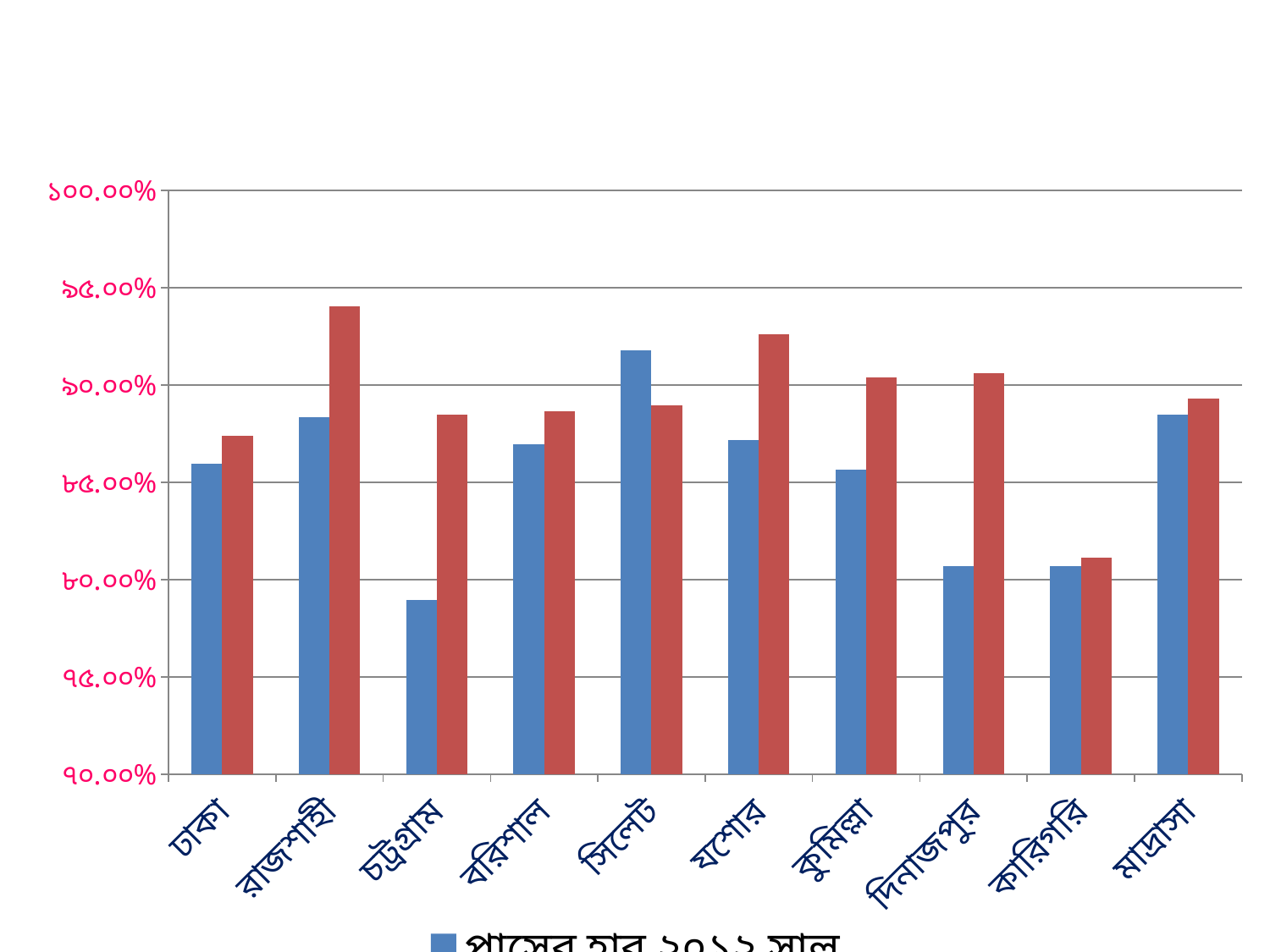
Which category has the highest blue bar in the chart? সিলেট Is the blue bar for সিলেট greater or less than ৯০.০০%? greater How many categories are shown along the x axis of the chart? 10 How many bars are plotted for each category in the chart? 2 Is the blue bar for চট্টগ্রাম greater or less than ৮০.০০%? less Which category has the highest red bar in the chart? রাজশাহী For সিলেট, which bar is taller, the blue one or the red one? blue Which category has the lowest red bar in the chart? কারিগরি What kind of chart is shown on the slide? bar chart Which category has the lowest blue bar in the chart? চট্রগ্রাম Is the red bar for রাজশাহী greater or less than ৯০.০০%? greater What is the legend label for the blue series in the chart? পাসের হার ২০১২ সাল